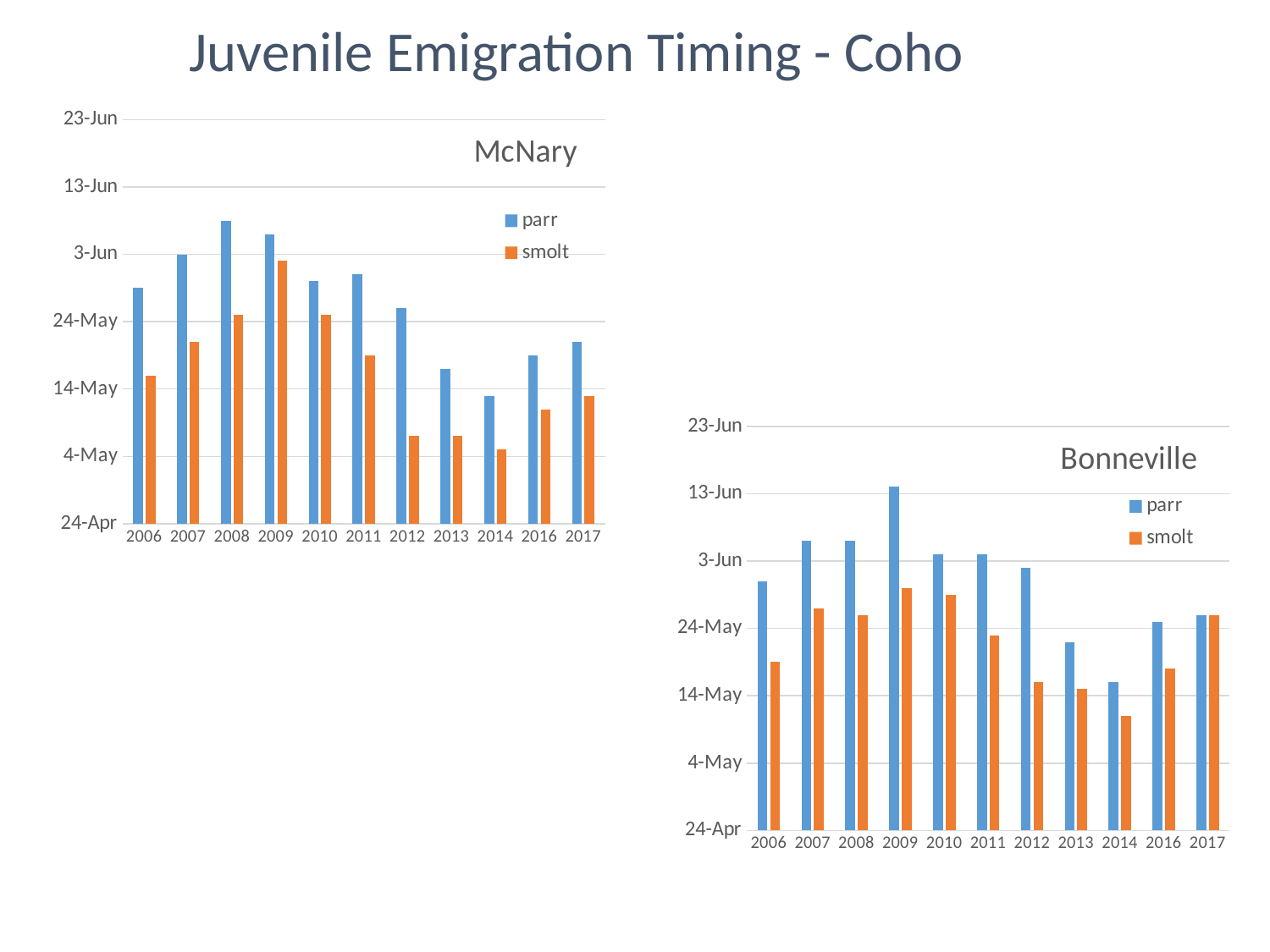
In the McNary chart, is the smolt value for 2012 greater or less than 14-May? less What kind of chart is the McNary chart? bar chart In the Bonneville chart, which year has the lowest smolt value? 2014 In the Bonneville chart, which year has the highest parr value? 2009 In the McNary chart, which year has the lowest parr value? 2014 How many series does the legend of the McNary chart list? 2 In the McNary chart, which year has the highest smolt value? 2009 How many years are shown on the x axis of the McNary chart? 11 In the McNary chart, is the parr value for 2008 greater or less than 3-Jun? greater In the Bonneville chart, which is larger for 2009, parr or smolt? parr What are the two series named in the legend of the Bonneville chart? parr and smolt In the McNary chart, which year has the highest parr value? 2008